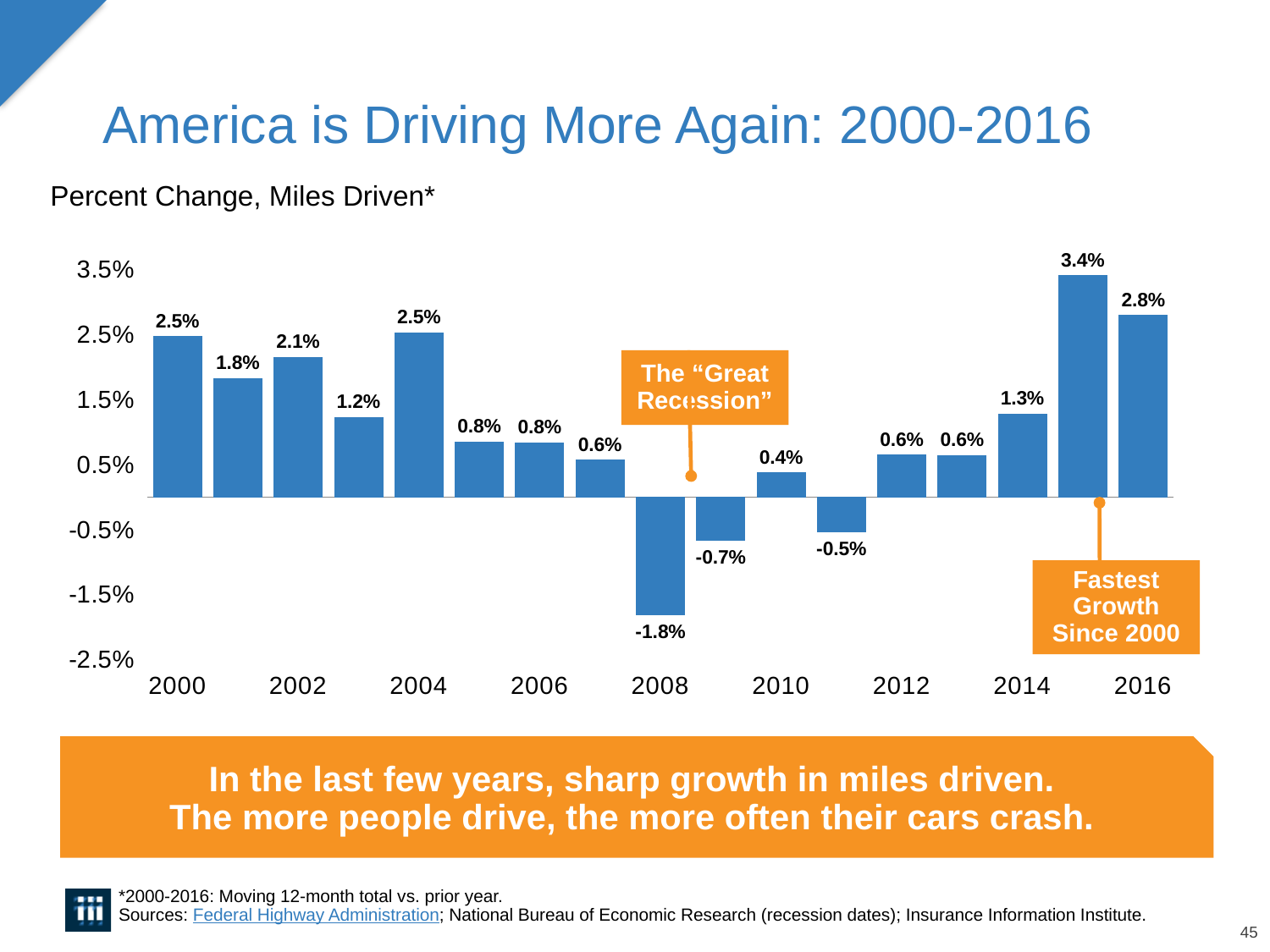
What is the percent change in miles driven for 2000? 2.5% How many years are plotted in the chart? 17 What is the difference between the percent change in 2016 and the percent change in 2014? 1.5% Which year has the highest percent change in miles driven? 2015 What does the orange callout pointing at the 2015 bar say? Fastest Growth Since 2000 What kind of chart is shown on the slide? Bar chart Which year has a larger percent change in miles driven, 2004 or 2012? 2004 Which year has the lowest percent change in miles driven? 2008 What is the percent change in miles driven for 2008? -1.8% Do the values generally rise or fall from 2012 to 2015? Rise What is the percent change in miles driven for 2016? 2.8% What is the percent change in miles driven for 2010? 0.4%